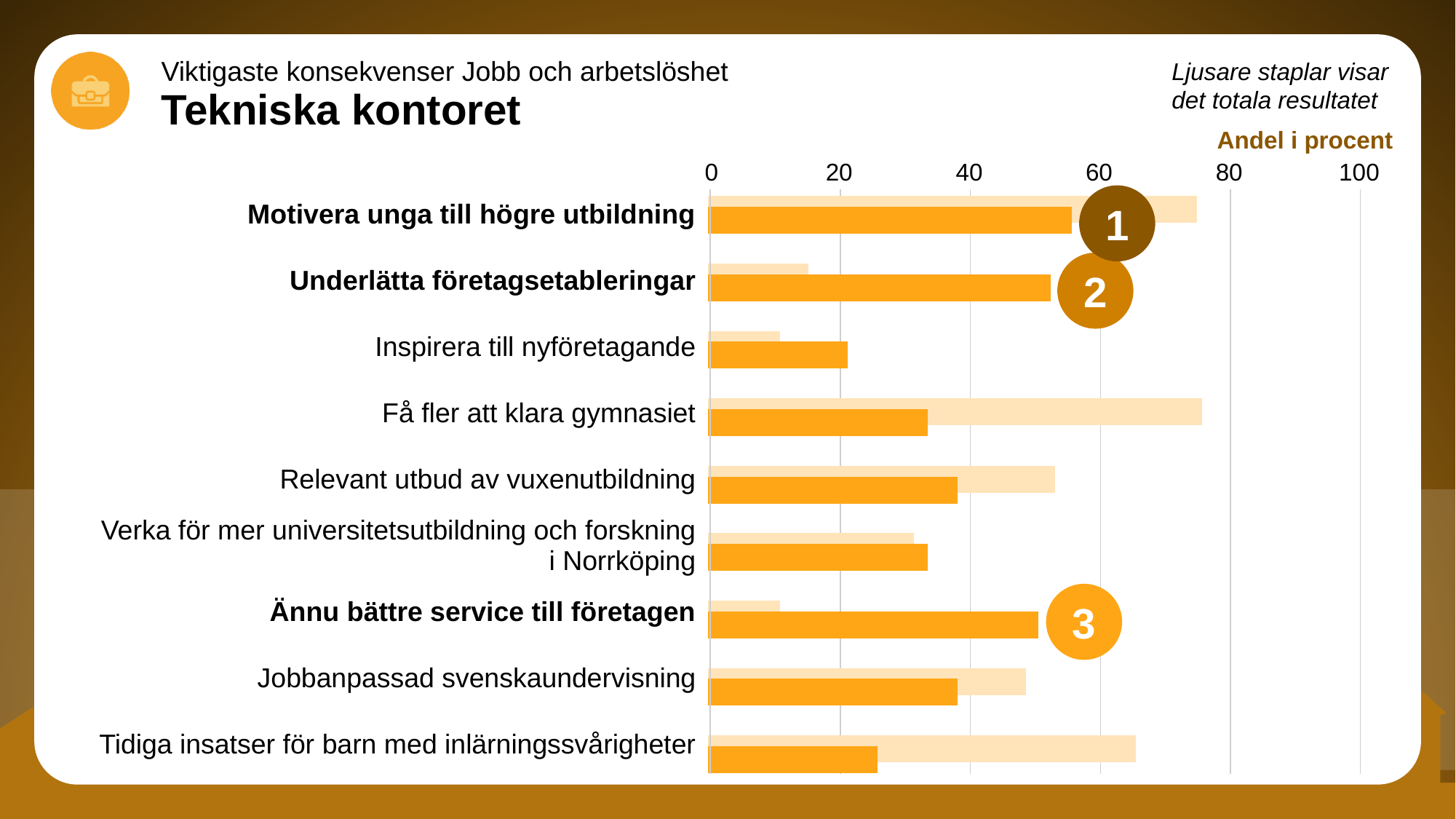
Is the dark orange value for Motivera unga till högre utbildning greater or less than 40? greater Which category has the shortest dark orange bar? Inspirera till nyföretagande For Få fler att klara gymnasiet, which bar is longer, the dark orange or the light orange one? light orange How many categories are plotted on the chart? 9 Is the light orange value for Underlätta företagsetableringar greater or less than 20? less What kind of chart is shown on the slide? bar chart Is the light orange value for Få fler att klara gymnasiet greater or less than 60? greater According to the note on the slide, what do the lighter bars show? det totala resultatet Which category has the longest dark orange bar? Motivera unga till högre utbildning For Underlätta företagsetableringar, which bar is longer, the dark orange or the light orange one? dark orange